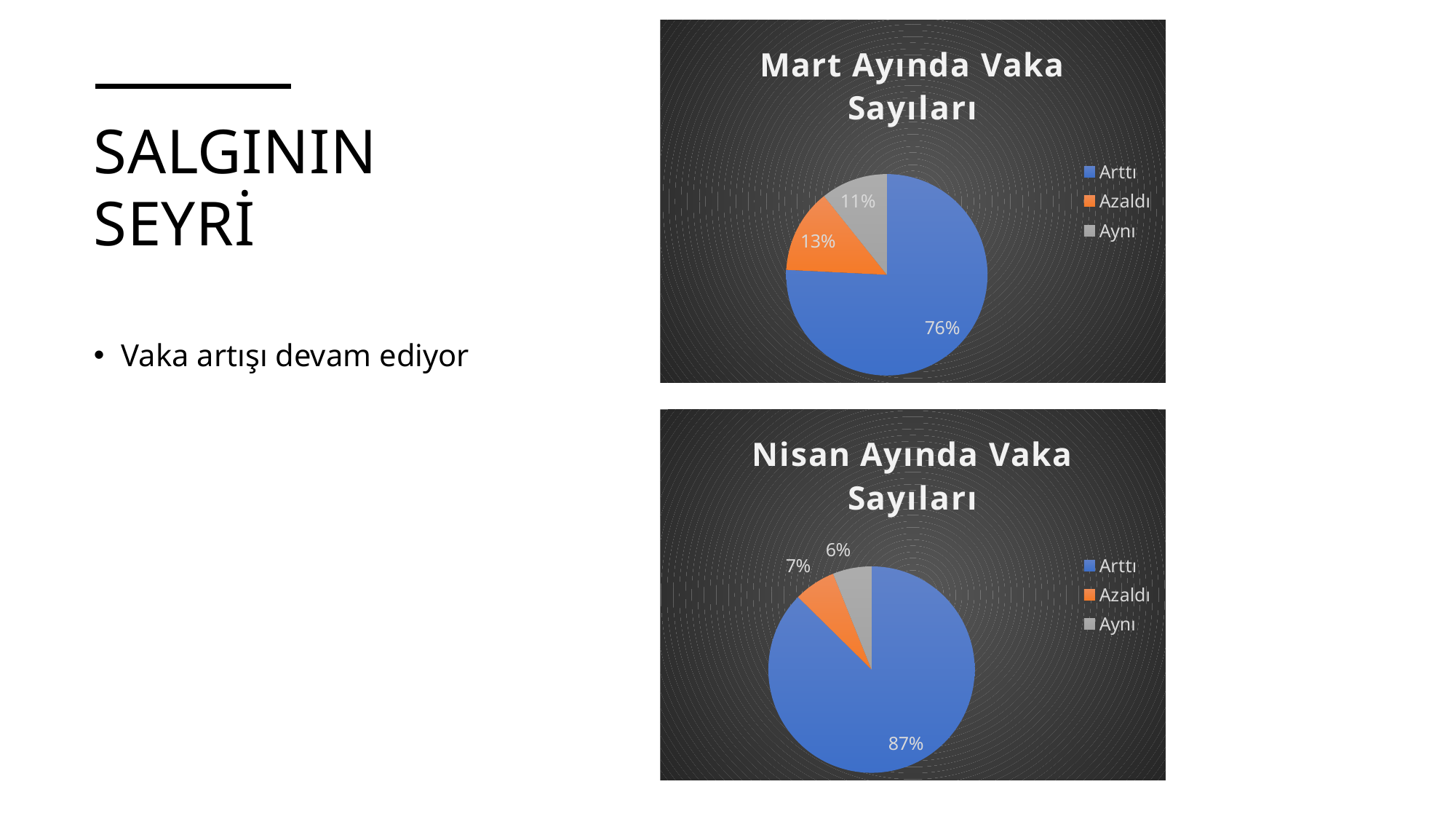
In the 'Nisan Ayında Vaka Sayıları' chart, which colour represents 'Azaldı'? Orange In the 'Mart Ayında Vaka Sayıları' chart, which category has the largest slice? Arttı In the 'Nisan Ayında Vaka Sayıları' chart, which category has the smallest slice? Aynı In the 'Mart Ayında Vaka Sayıları' chart, what share does 'Azaldı' have? 13% In the 'Mart Ayında Vaka Sayıları' chart, what is the difference between the 'Azaldı' and 'Aynı' shares? 2% In the 'Nisan Ayında Vaka Sayıları' chart, what share does 'Aynı' have? 6% In the 'Nisan Ayında Vaka Sayıları' chart, what share does 'Arttı' have? 87% In the 'Mart Ayında Vaka Sayıları' chart, what share does 'Arttı' have? 76% How many categories does the legend of the 'Mart Ayında Vaka Sayıları' chart list? 3 What kind of chart is the 'Nisan Ayında Vaka Sayıları' chart? Pie chart In the 'Mart Ayında Vaka Sayıları' chart, what share does 'Aynı' have? 11% In the 'Nisan Ayında Vaka Sayıları' chart, what share does 'Azaldı' have? 7%